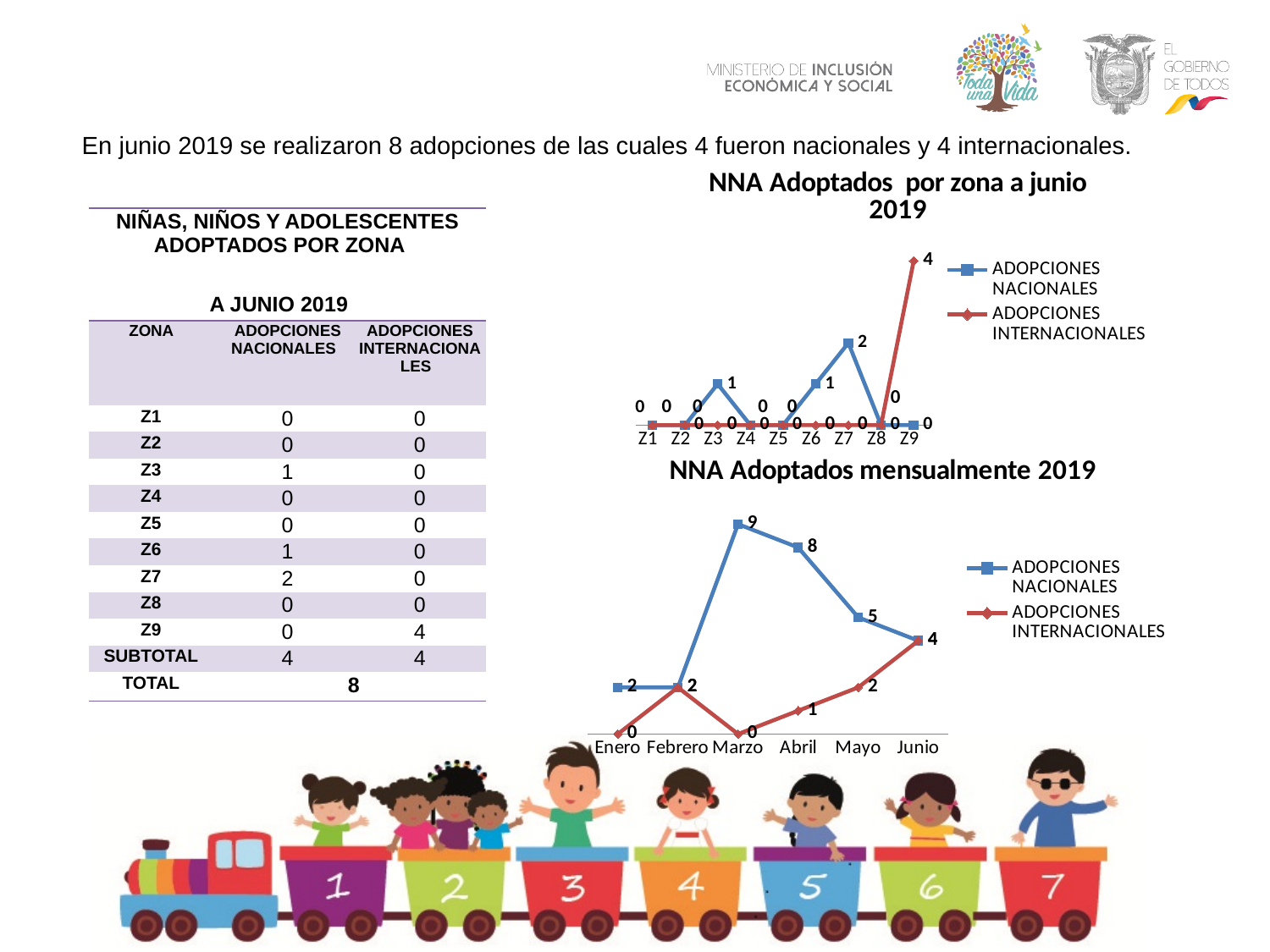
What kind of chart is 'NNA Adoptados mensualmente 2019'? line chart In the 'NNA Adoptados por zona a junio 2019' chart, what is the value of ADOPCIONES INTERNACIONALES for Z9? 4 In the 'NNA Adoptados mensualmente 2019' chart, what is the value of ADOPCIONES NACIONALES for Marzo? 9 In the 'NNA Adoptados mensualmente 2019' chart, which is larger in Mayo: ADOPCIONES NACIONALES or ADOPCIONES INTERNACIONALES? ADOPCIONES NACIONALES In the 'NNA Adoptados mensualmente 2019' chart, what is the difference between ADOPCIONES NACIONALES and ADOPCIONES INTERNACIONALES in Abril? 7 In the 'NNA Adoptados por zona a junio 2019' chart, which zone has the highest value for ADOPCIONES NACIONALES? Z7 In the 'NNA Adoptados mensualmente 2019' chart, what is the value of ADOPCIONES INTERNACIONALES for Abril? 1 In the 'NNA Adoptados por zona a junio 2019' chart, what is the value of ADOPCIONES NACIONALES for Z7? 2 In the 'NNA Adoptados por zona a junio 2019' chart, how many series does the legend list? 2 In the 'NNA Adoptados por zona a junio 2019' chart, how many zones are shown on the x axis? 9 In the 'NNA Adoptados mensualmente 2019' chart, do the ADOPCIONES NACIONALES values rise or fall from Marzo to Junio? fall In the 'NNA Adoptados mensualmente 2019' chart, which month has the highest value for ADOPCIONES NACIONALES? Marzo